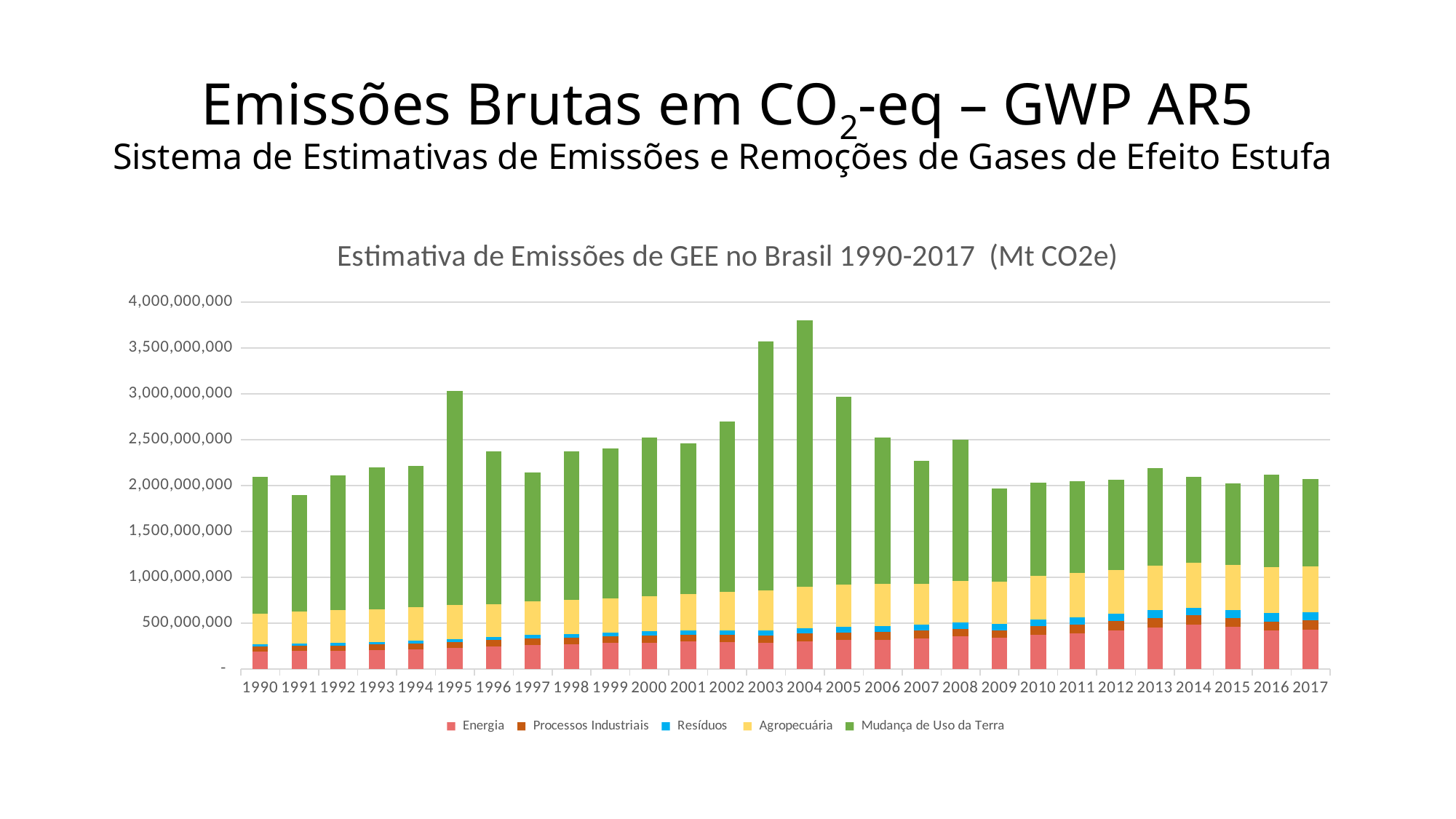
What kind of chart is shown on the slide? Stacked bar chart Which series is shown in green in the chart? Mudança de Uso da Terra Which year has the highest total emissions in the chart? 2004 Which year has the larger total emissions, 2008 or 2009? 2008 Is the total for 2004 greater or less than 3,500,000,000? greater Is the total for 2007 greater or less than 2,500,000,000? less Is the total for 1991 greater or less than 2,000,000,000? less How many years (categories) are plotted on the x axis of the chart? 28 Does the Energia segment generally rise or fall from 1990 to 2017? rise How many series does the chart's legend list? 5 Which year has the larger total emissions, 1995 or 1996? 1995